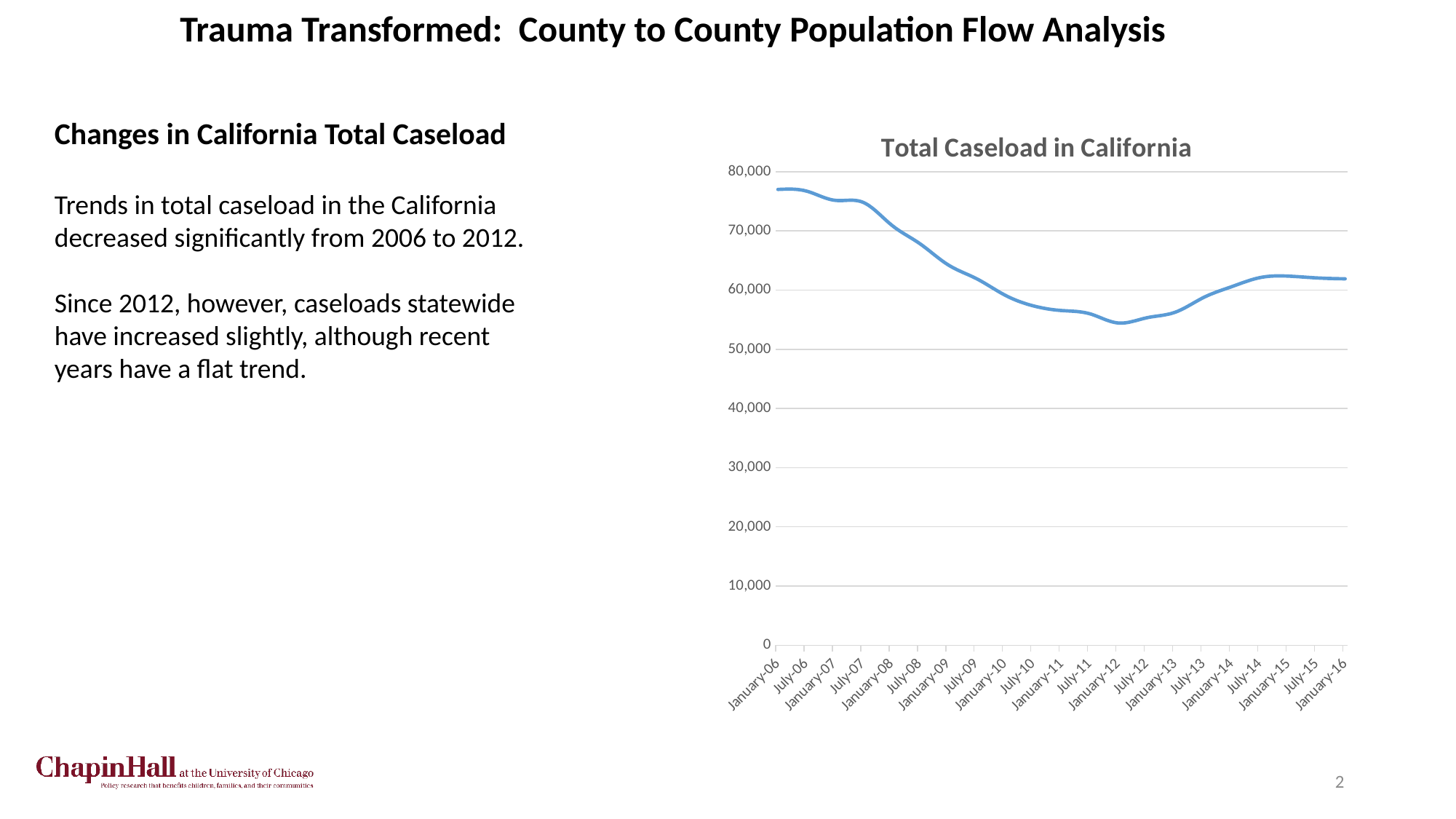
At which x-axis date is the total caseload in California lowest? January-12 Is the total caseload in California at January-06 greater or less than 70,000? greater What is the title of the chart on the slide? Total Caseload in California Is the total caseload in California at January-12 greater or less than 60,000? less Is the total caseload in California at January-16 greater or less than 60,000? greater What kind of chart is "Total Caseload in California"? line chart Does the total caseload in California rise or fall between January-12 and January-15? rise Which is larger, the total caseload in California at January-06 or at January-16? January-06 At which x-axis date is the total caseload in California highest? January-06 Does the total caseload in California rise or fall between January-06 and January-12? fall How many date labels are shown on the x axis of the chart? 21